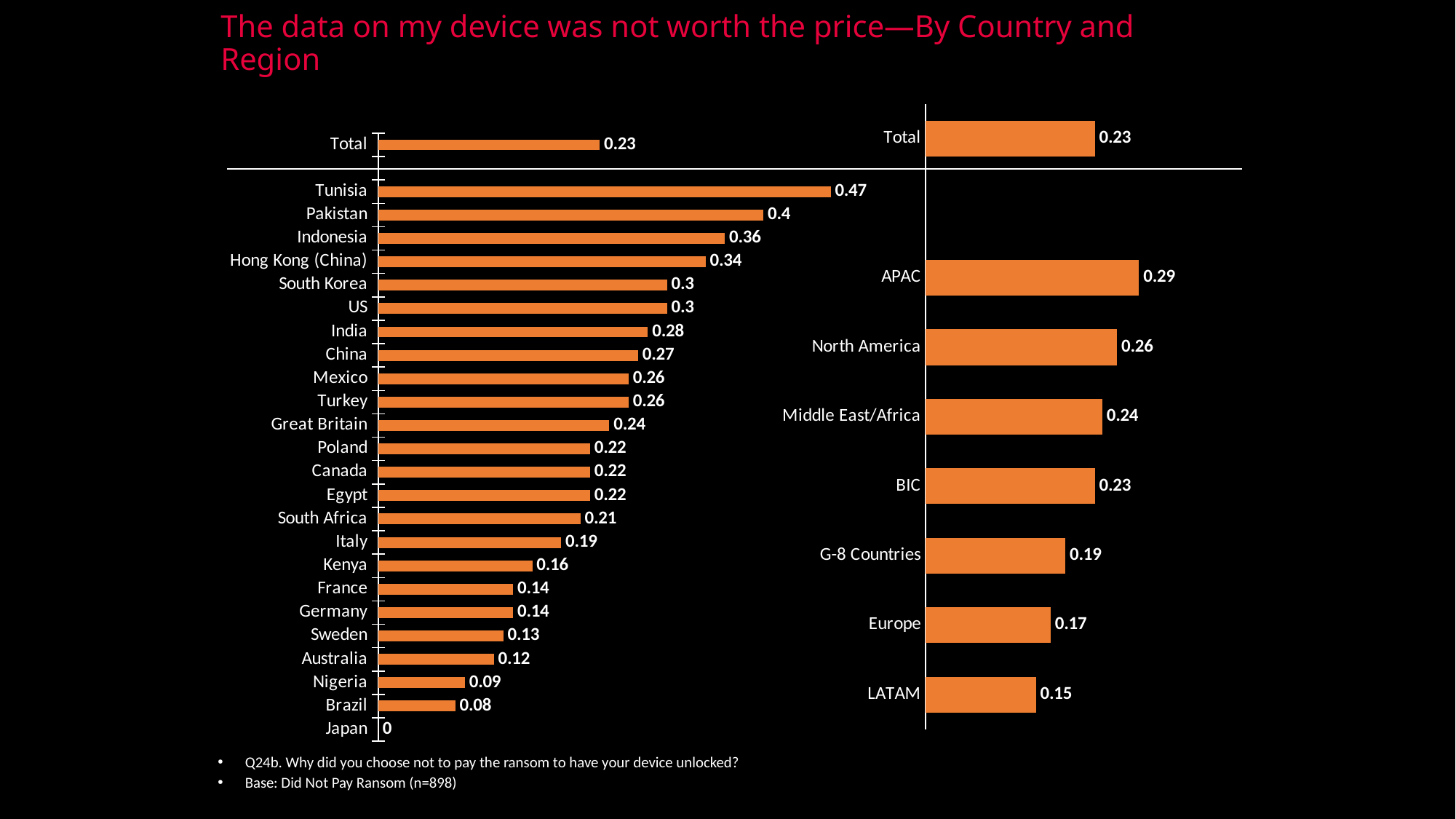
In the right chart (by region), how many regions are shown below the Total bar? 7 In the left chart (by country), what is the difference between the values for Tunisia and Pakistan? 0.07 In the left chart (by country), which country has the lowest value? Japan In the right chart (by region), which region has the lowest value? LATAM In the left chart (by country), how many countries are listed below the Total bar? 24 In the left chart (by country), what is the value for Tunisia? 0.47 In the left chart (by country), which has the larger value, Indonesia or India? Indonesia In the right chart (by region), what is the difference between the values for APAC and Europe? 0.12 In the right chart (by region), which region has the highest value? APAC What type of chart is used on the left side of the slide? Bar chart In the left chart (by country), what is the value for Great Britain? 0.24 In the right chart (by region), what is the value for North America? 0.26